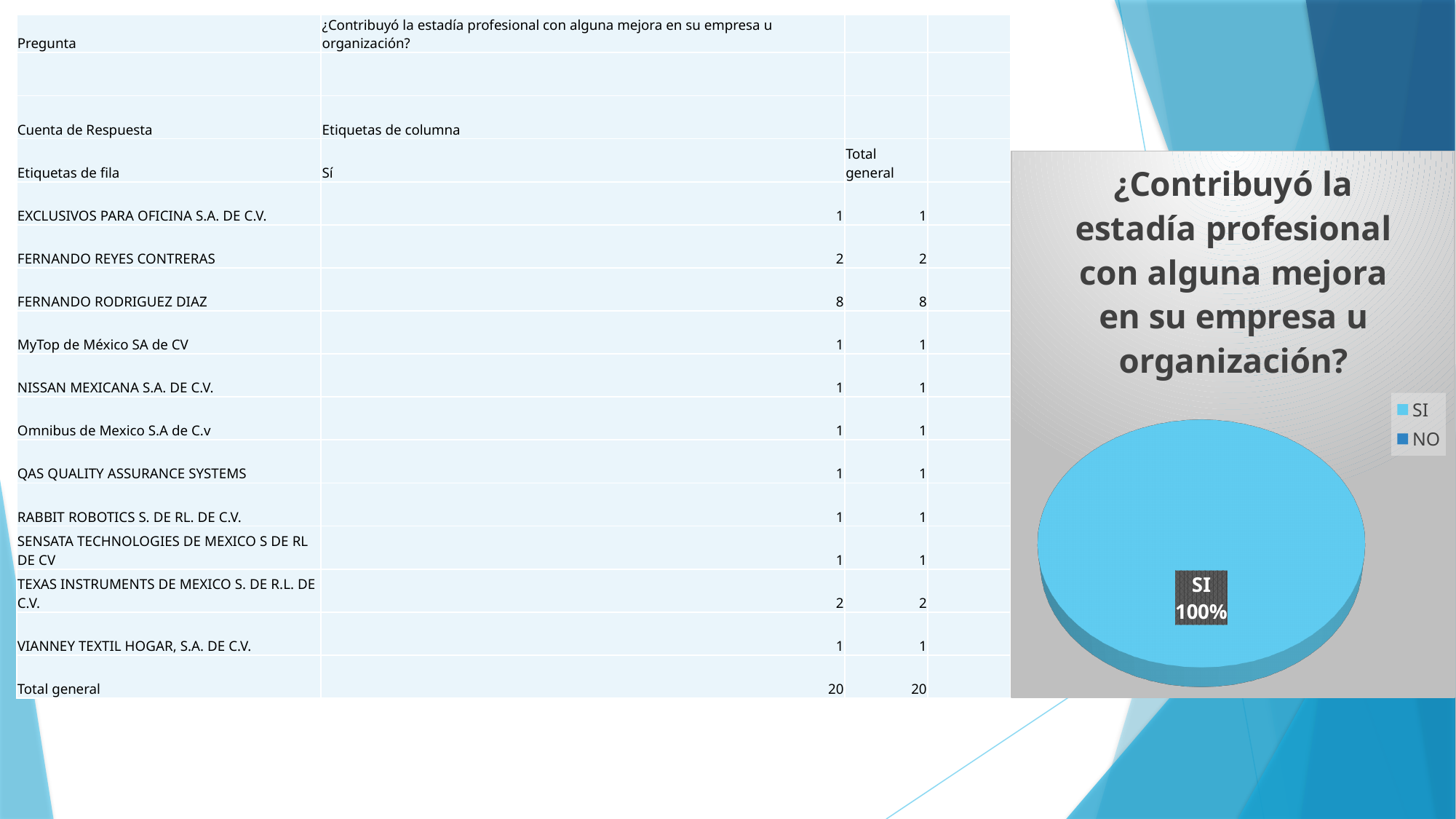
How many slices are visible in the pie chart? 1 What kind of chart is shown on the slide? pie chart How many entries does the chart's legend list? 2 What are the two legend entries of the pie chart? SI and NO Is the share for SI greater or less than 50%? greater Which of the two categories, SI or NO, has the larger share? SI What share of the pie does the SI slice represent? 100% Which category has the largest share of the pie? SI What is the title of the pie chart? ¿Contribuyó la estadía profesional con alguna mejora en su empresa u organización? Which category has the smaller share of the pie, SI or NO? NO